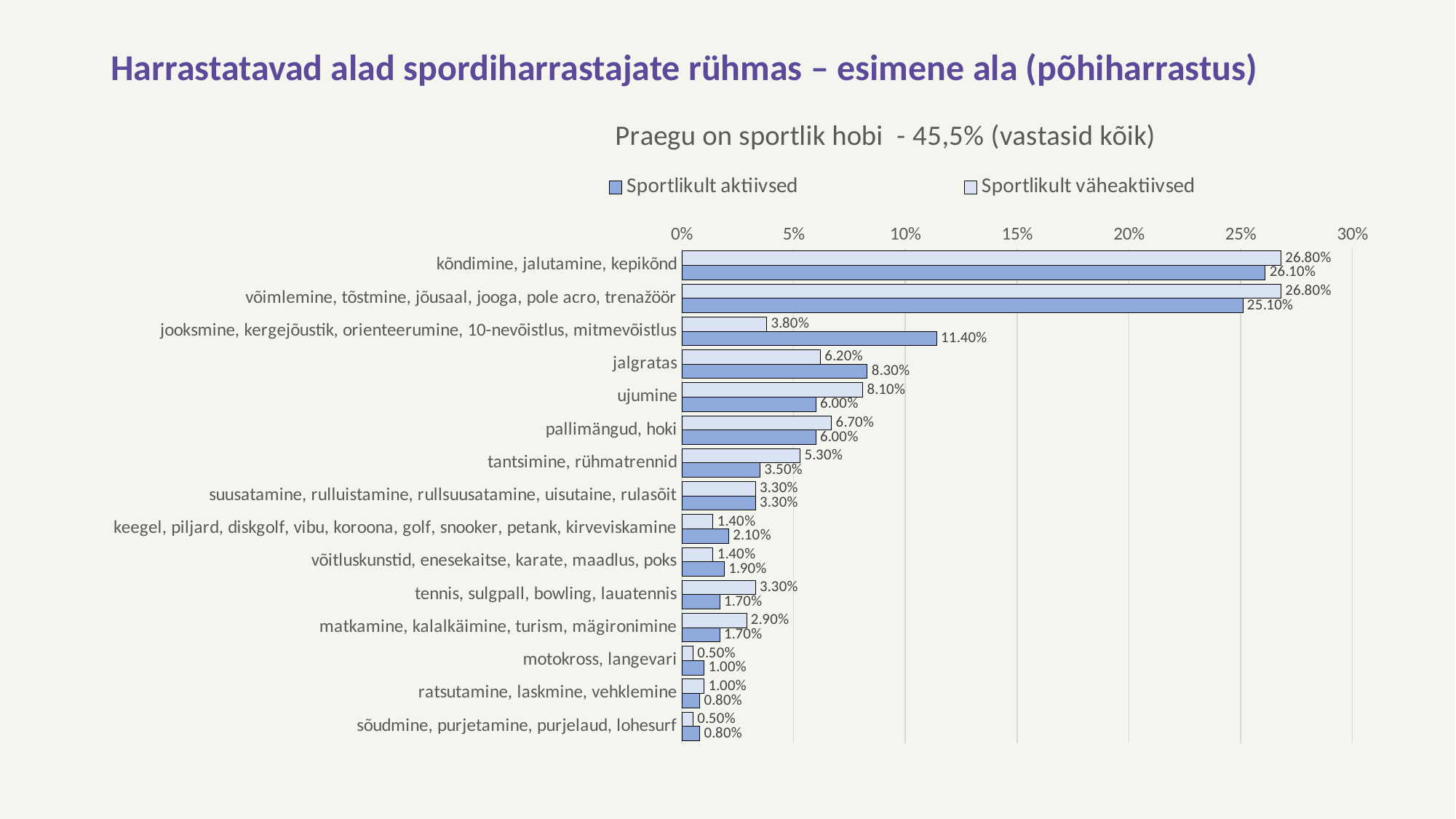
Which category has the highest value for "Sportlikult aktiivsed"? kõndimine, jalutamine, kepikõnd What is the value for "Sportlikult aktiivsed" in the category "jalgratas"? 8.30% How many categories are shown on the chart? 15 How many series does the legend list? 2 Is the value for "Sportlikult aktiivsed" in "võimlemine, tõstmine, jõusaal, jooga, pole acro, trenažöör" greater or less than 20%? greater What is the value for "Sportlikult aktiivsed" in the category "jooksmine, kergejõustik, orienteerumine, 10-nevõistlus, mitmevõistlus"? 11.40% What kind of chart is shown on the slide? Bar chart What is the title of the chart? Praegu on sportlik hobi - 45,5% (vastasid kõik) What is the value for "Sportlikult väheaktiivsed" in the category "ujumine"? 8.10% For "tantsimine, rühmatrennid", which series has the larger value: "Sportlikult aktiivsed" or "Sportlikult väheaktiivsed"? Sportlikult väheaktiivsed Which category has the lowest value for "Sportlikult väheaktiivsed"? motokross, langevari and sõudmine, purjetamine, purjelaud, lohesurf (both 0.50%) What is the difference between the "Sportlikult aktiivsed" and "Sportlikult väheaktiivsed" values for "jooksmine, kergejõustik, orienteerumine, 10-nevõistlus, mitmevõistlus"? 7.60%